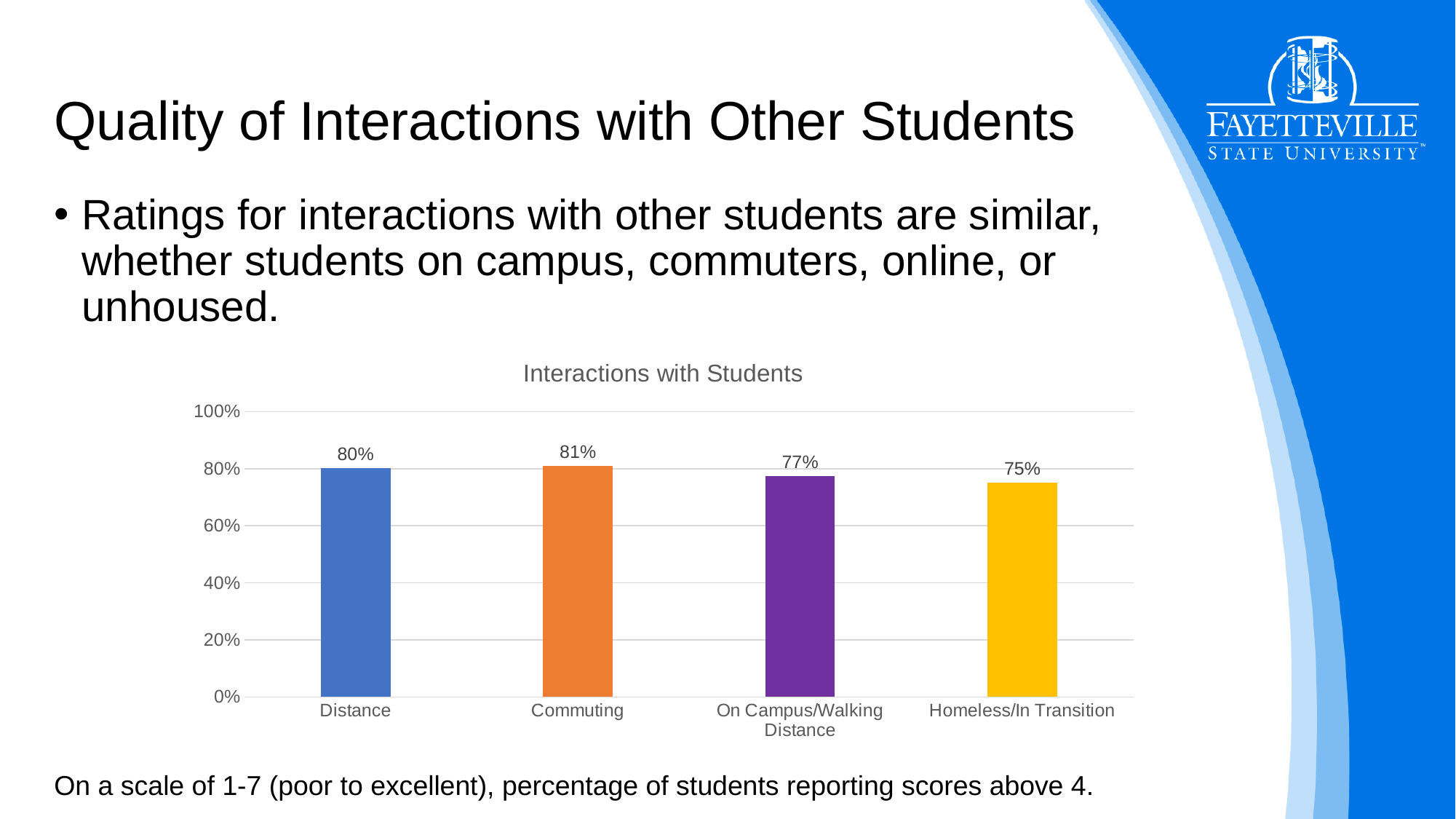
What is the value for Homeless/In Transition? 75% Which category has the lowest value? Homeless/In Transition What is the difference between the values for Commuting and Homeless/In Transition? 6% Which category has the highest value? Commuting Which is larger, the value for Distance or the value for Homeless/In Transition? Distance What is the title of the chart? Interactions with Students How many categories are shown in the chart? 4 What is the value for Distance? 80% What is the value for Commuting? 81% What is the difference between the values for Distance and On Campus/Walking Distance? 3% What kind of chart is shown on the slide? Bar chart What is the value for On Campus/Walking Distance? 77%